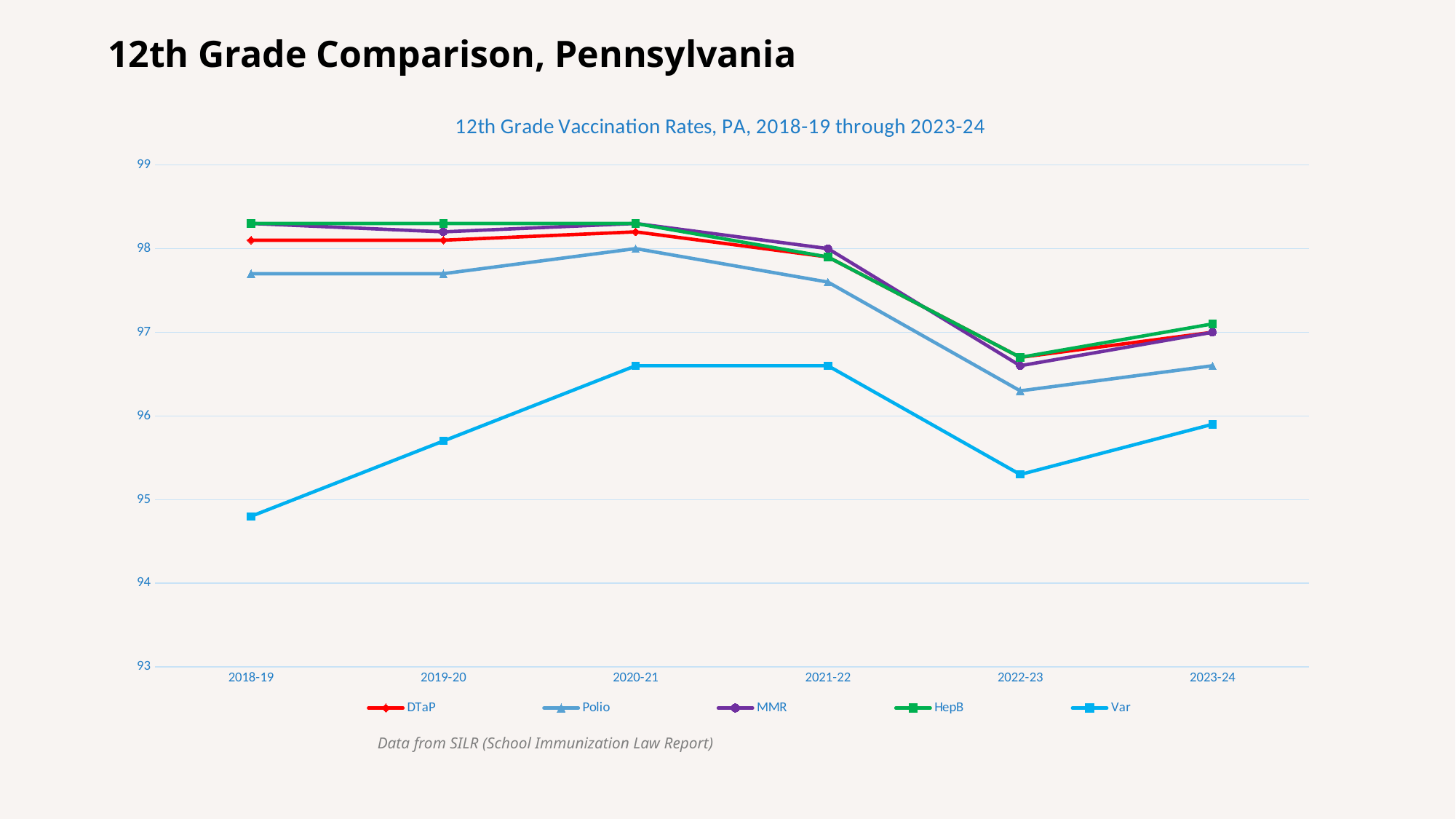
Does the Var series rise or fall from 2018-19 to 2020-21? rise What is the title of the chart? 12th Grade Vaccination Rates, PA, 2018-19 through 2023-24 Is the value for Polio in 2022-23 greater or less than 96? greater In which school year is the Var series at its lowest? 2018-19 Which series has the lowest values across all years? Var Which is larger, the Var value in 2018-19 or the Var value in 2023-24? 2023-24 How many series does the legend list? 5 What kind of chart is shown on the slide? line chart How many school years are shown on the x axis? 6 Is the value for Var in 2022-23 greater or less than 95? greater Is the value for Var in 2018-19 greater or less than 95? less In which school year is the Polio series at its highest? 2020-21